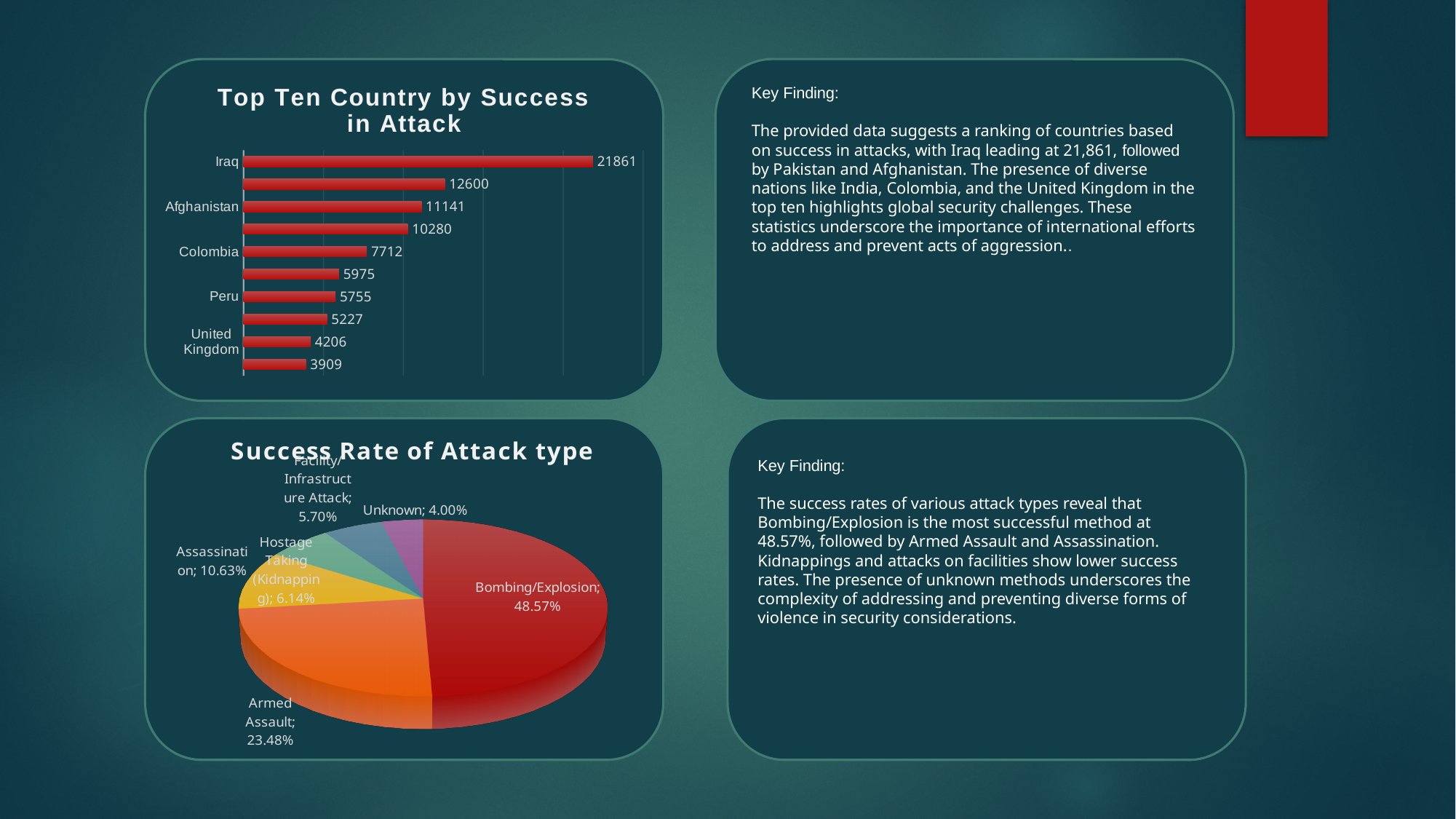
In the 'Top Ten Country by Success in Attack' chart, what is the value for Colombia? 7712 In the 'Top Ten Country by Success in Attack' chart, which country has the highest value? Iraq In the 'Success Rate of Attack type' chart, which attack type has the smallest share? Unknown In the 'Success Rate of Attack type' chart, which is larger: Assassination or Hostage Taking (Kidnapping)? Assassination What kind of chart is 'Top Ten Country by Success in Attack'? Bar chart In the 'Success Rate of Attack type' chart, what share does Bombing/Explosion have? 48.57% In the 'Top Ten Country by Success in Attack' chart, what is the value for Iraq? 21861 In the 'Top Ten Country by Success in Attack' chart, what is the value for Afghanistan? 11141 In the 'Top Ten Country by Success in Attack' chart, what is the difference between the values for Iraq and Afghanistan? 10720 In the 'Top Ten Country by Success in Attack' chart, what is the value for the United Kingdom? 4206 How many bars are plotted in the 'Top Ten Country by Success in Attack' chart? 10 In the 'Success Rate of Attack type' chart, what is the value for Armed Assault? 23.48%